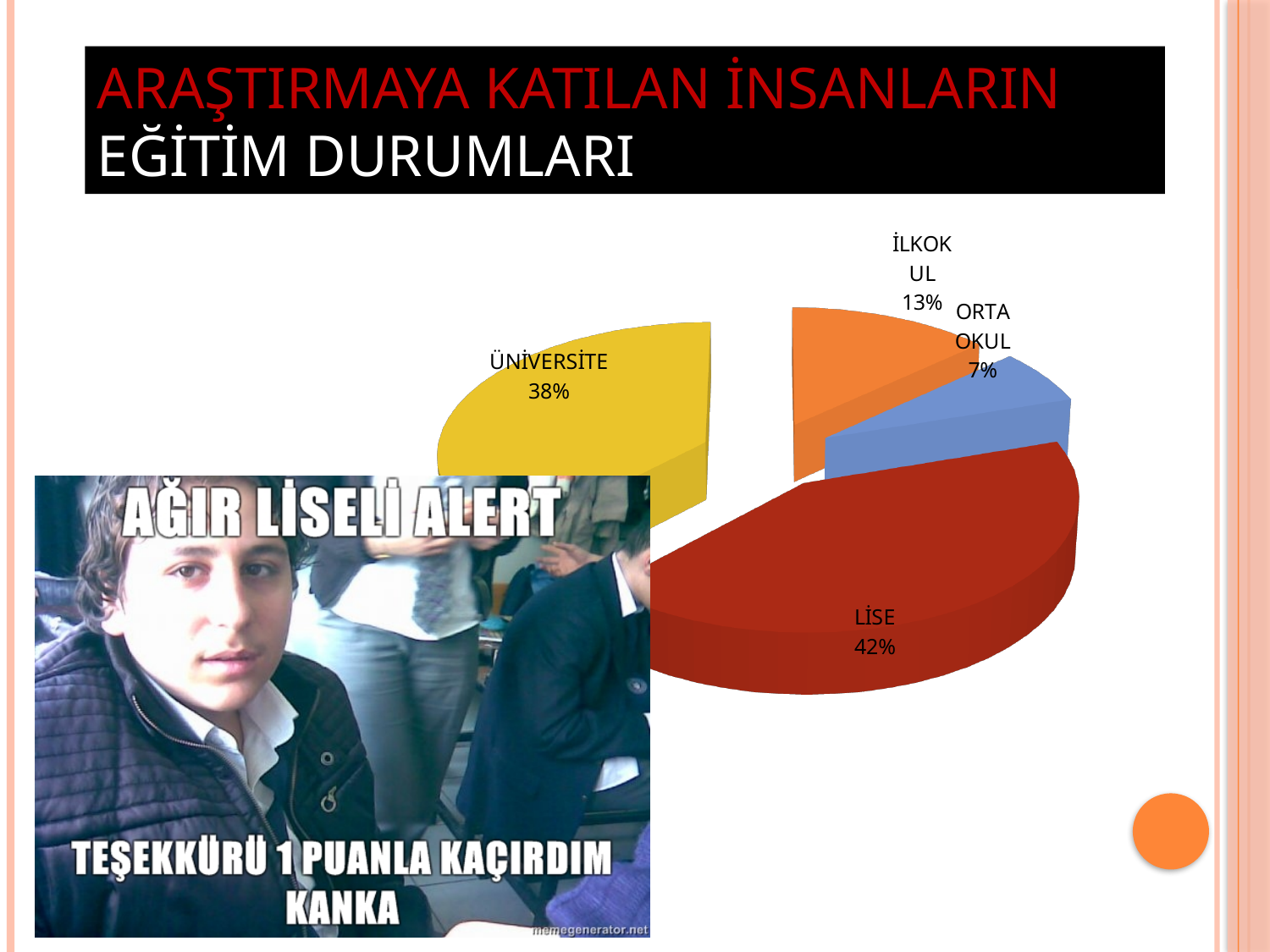
What colour is the LİSE slice of the pie? Red What is the value shown for İLKOKUL? 13% Which category has the smallest slice of the pie? ORTA OKUL What is the difference between the LİSE and ÜNİVERSİTE shares? 4% How many categories are shown in the pie chart? 4 What is the difference between the İLKOKUL and ORTA OKUL shares? 6% What is the value shown for ORTA OKUL? 7% What share of the pie does LİSE represent? 42% Which category has the largest slice of the pie? LİSE What kind of chart is shown on the slide? Pie chart Which is larger, the share for İLKOKUL or the share for ORTA OKUL? İLKOKUL What share of the pie does ÜNİVERSİTE represent? 38%